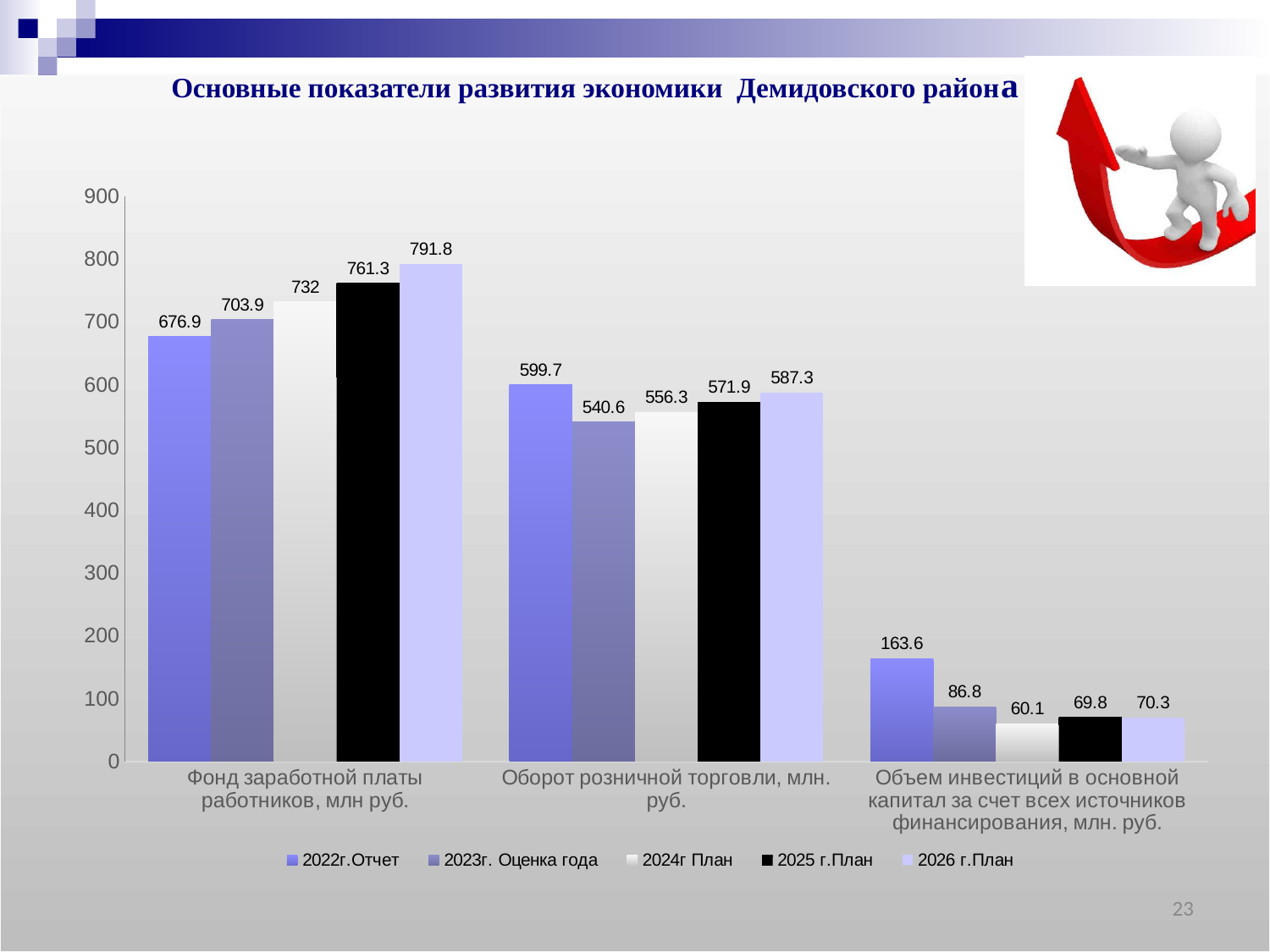
What is the title of the slide? Основные показатели развития экономики Демидовского района What is the difference between the 2026 г.План and 2022г.Отчет values for "Фонд заработной платы работников, млн руб."? 114.9 How many categories are shown on the x axis? 3 Do the values for "Фонд заработной платы работников, млн руб." rise or fall from 2022г.Отчет to 2026 г.План? Rise How many series does the legend list? 5 Which series has the highest value in the category "Фонд заработной платы работников, млн руб."? 2026 г.План What kind of chart is shown on the slide? Bar chart What is the value for 2024г План in the category "Объем инвестиций в основной капитал за счет всех источников финансирования, млн. руб."? 60.1 Which series has the lowest value in the category "Объем инвестиций в основной капитал за счет всех источников финансирования, млн. руб."? 2024г План What is the value for 2026 г.План in the category "Оборот розничной торговли, млн. руб."? 587.3 Which is larger in the category "Оборот розничной торговли, млн. руб.": the 2022г.Отчет value or the 2023г. Оценка года value? 2022г.Отчет What is the value for 2022г.Отчет in the category "Фонд заработной платы работников, млн руб."? 676.9